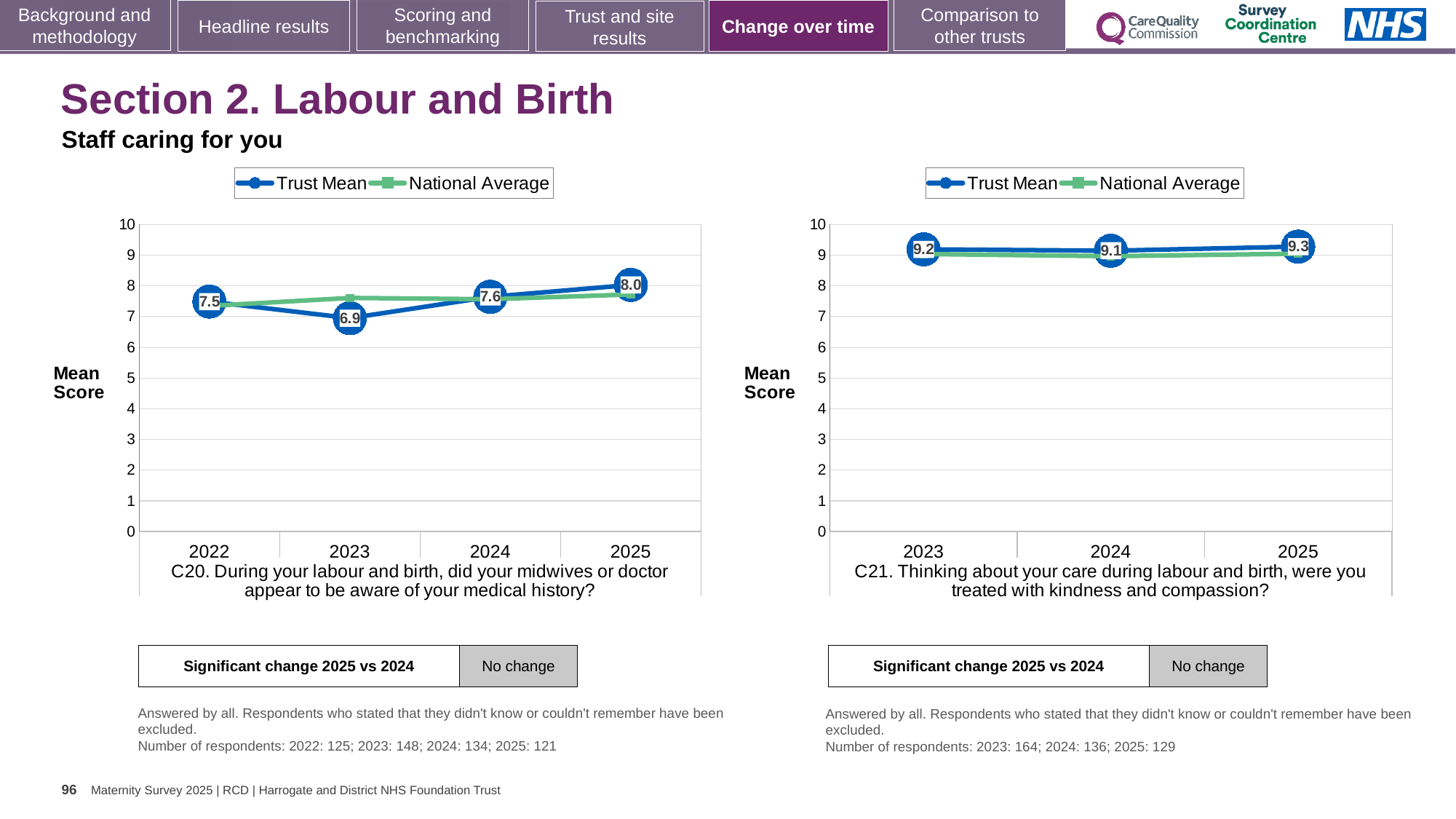
In the C20 chart (left), is the Trust Mean higher in 2022 or in 2024? 2024 In the C20 chart (left), which year has the highest Trust Mean? 2025 In the C21 chart (right), which year has the highest Trust Mean? 2025 What kind of chart is the C20 chart (left)? Line chart In the C20 chart (left), what is the difference between the Trust Mean in 2025 and in 2023? 1.1 In the C20 chart (left), which year has the lowest Trust Mean? 2023 How many series does the legend of the C21 chart (right) list? 2 In the C21 chart (right), is the National Average for 2025 greater or less than 8? greater In the C21 chart (right), what is the Trust Mean for 2024? 9.1 In the C20 chart (left), what is the Trust Mean for 2025? 8.0 In the C20 chart (left), how many years are shown on the x axis? 4 In the C20 chart (left), what is the Trust Mean for 2023? 6.9